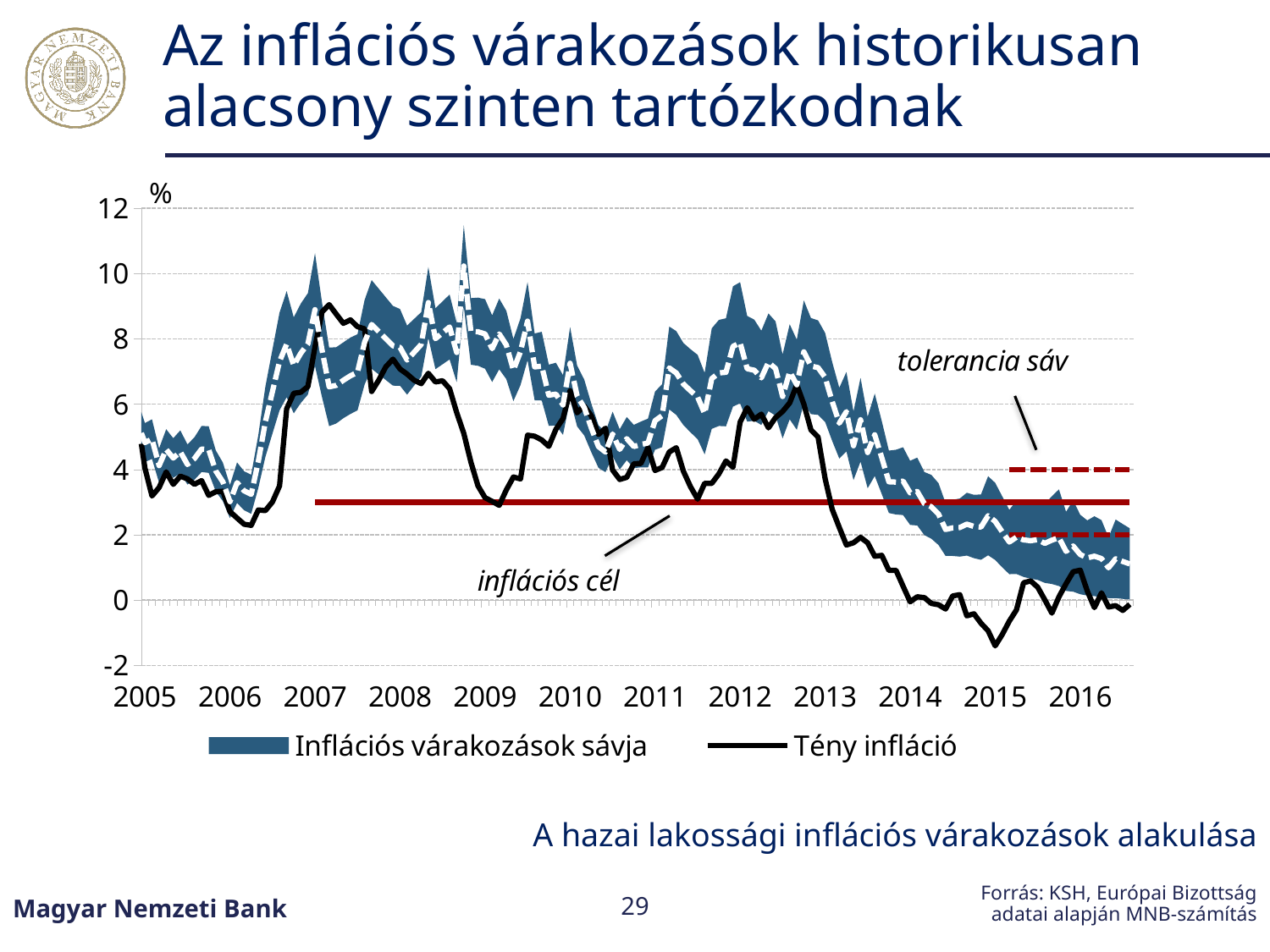
At what value is the lower dashed line of the 'tolerancia sáv' drawn? 2 How many series does the legend list? 2 What kind of chart is shown on the slide? combination area and line chart Is the value of 'Tény infláció' at the end of 2016 greater or less than 2? less How many years are labelled on the x axis? 12 At what value on the y axis is the solid red 'inflációs cél' line drawn? 3 What unit is shown at the top of the y axis? % At what value is the upper dashed line of the 'tolerancia sáv' drawn? 4 Does 'Tény infláció' rise or fall between 2013 and 2015? fall Is the value of 'Tény infláció' at the start of 2015 greater or less than 0? less